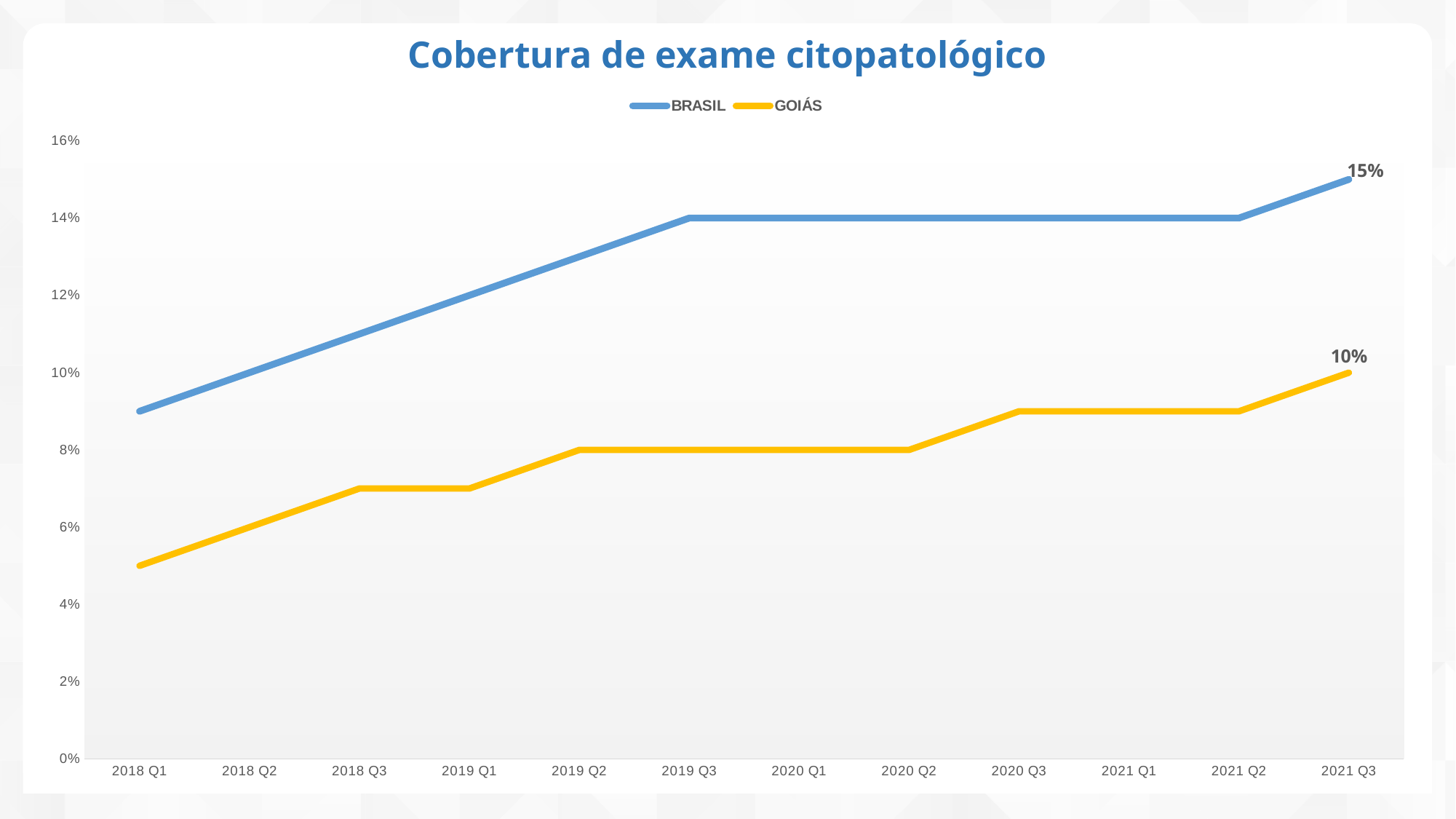
What kind of chart is shown on the slide? Line chart Does the GOIÁS line generally rise or fall from 2018 Q1 to 2021 Q3? Rise What is the value for BRASIL in 2021 Q3? 15% What is the value for GOIÁS in 2021 Q3? 10% Which colour is used for the GOIÁS line? Yellow Is the value for GOIÁS in 2018 Q1 greater or less than 6%? less Is the value for BRASIL in 2018 Q1 greater or less than 8%? greater What is the title of the chart? Cobertura de exame citopatológico How many quarters are shown along the x axis? 12 What is the difference between the BRASIL and GOIÁS values in 2021 Q3? 5% How many series does the legend list? 2 Which series has the higher value in 2021 Q3, BRASIL or GOIÁS? BRASIL